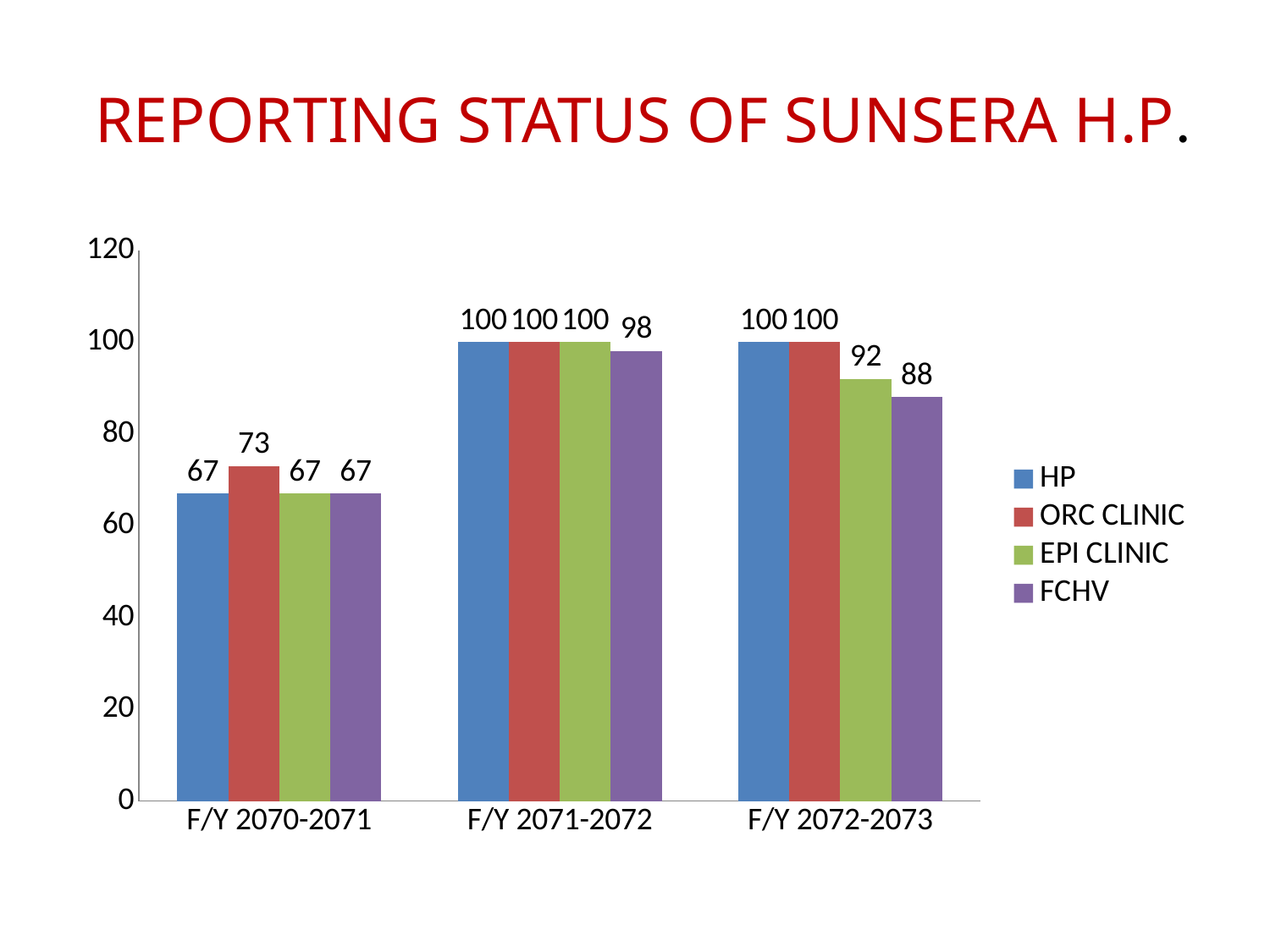
How many series does the legend list? 4 What kind of chart is shown on the slide? Bar chart What is the value for FCHV in F/Y 2072-2073? 88 Which is larger: the EPI CLINIC value in F/Y 2072-2073 or the FCHV value in F/Y 2071-2072? FCHV value in F/Y 2071-2072 What is the difference between the ORC CLINIC value and the HP value in F/Y 2070-2071? 6 Which series has the highest value in F/Y 2070-2071? ORC CLINIC What is the value for FCHV in F/Y 2071-2072? 98 What is the title of the slide? REPORTING STATUS OF SUNSERA H.P. What is the value for ORC CLINIC in F/Y 2070-2071? 73 Which series has the lowest value in F/Y 2072-2073? FCHV How many fiscal year categories are shown on the x axis? 3 What is the value for EPI CLINIC in F/Y 2072-2073? 92